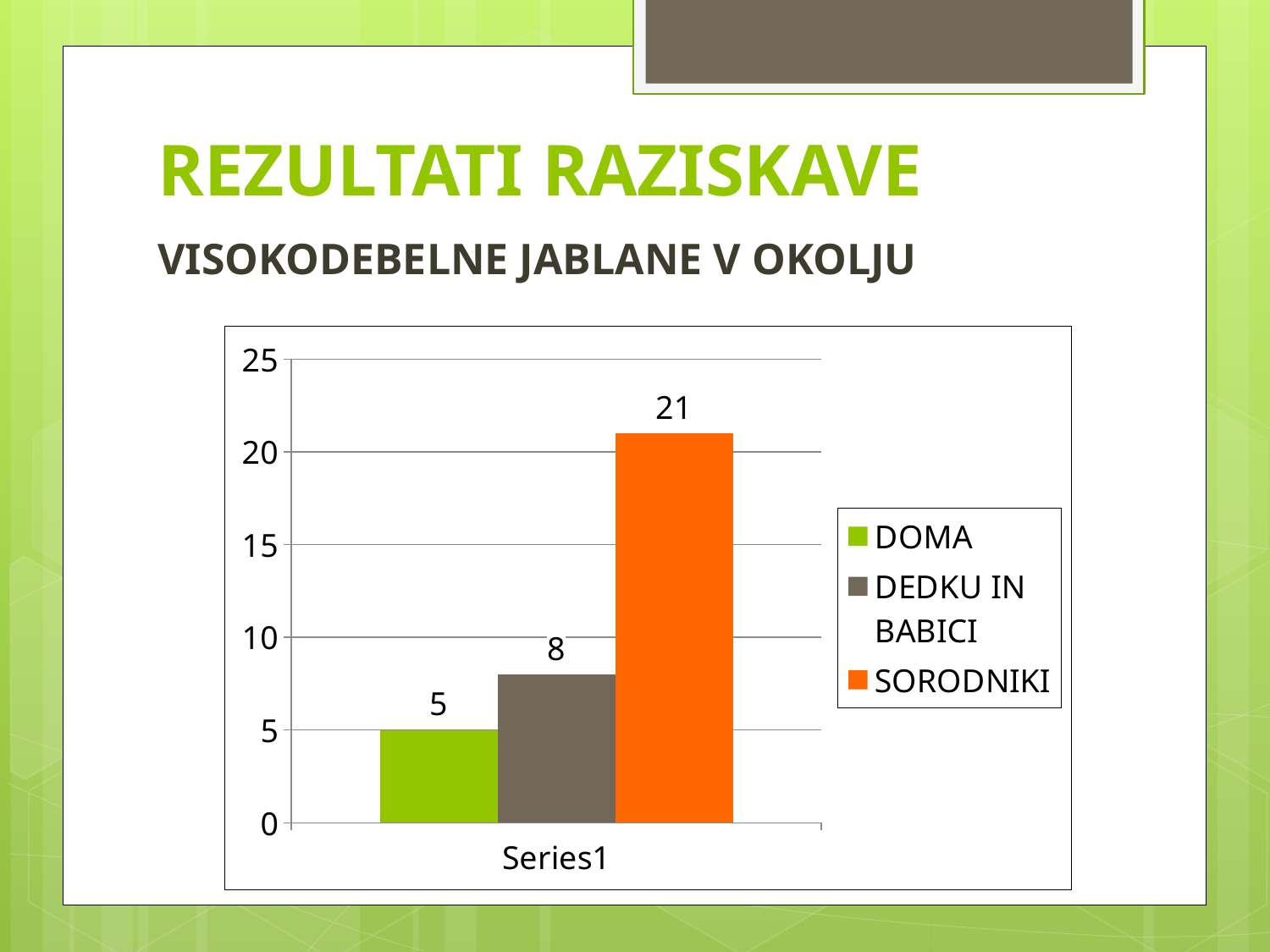
What kind of chart is shown on the slide? bar chart What is the difference between the values for SORODNIKI and DOMA? 16 Which legend entry has the highest value? SORODNIKI What is the label shown on the x axis below the bars? Series1 Which legend entry has the lowest value? DOMA Is the value for SORODNIKI greater or less than 20? greater Which is larger, the value for DEDKU IN BABICI or the value for DOMA? DEDKU IN BABICI What is the value for DOMA? 5 How many series does the legend list? 3 What is the value for DEDKU IN BABICI? 8 What is the difference between the values for DEDKU IN BABICI and DOMA? 3 What is the value for SORODNIKI? 21